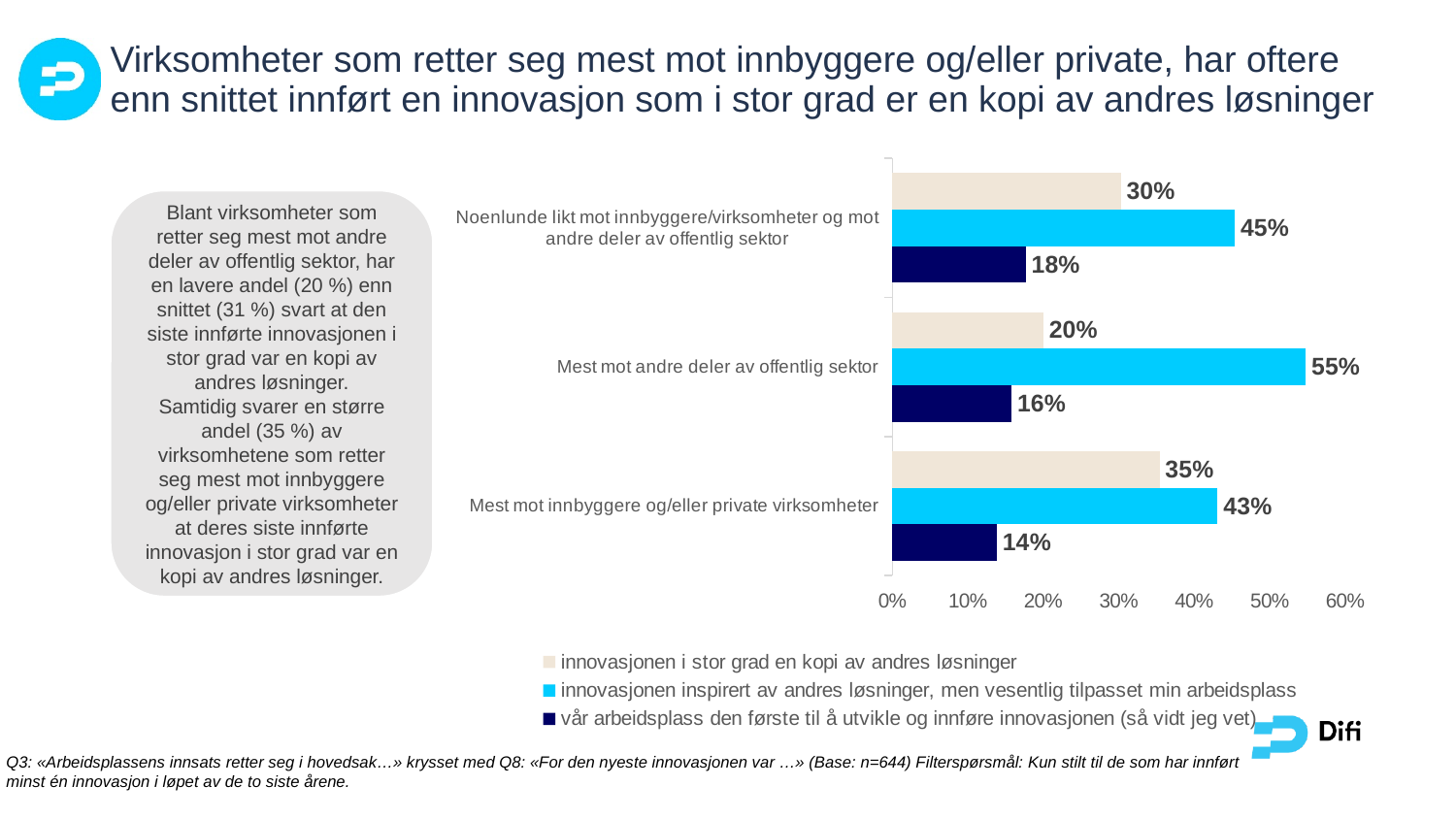
Which is larger: the 'innovasjonen i stor grad en kopi av andres løsninger' value for 'Noenlunde likt mot innbyggere/virksomheter og mot andre deler av offentlig sektor' or for 'Mest mot andre deler av offentlig sektor'? Noenlunde likt mot innbyggere/virksomheter og mot andre deler av offentlig sektor How many series does the legend list? 3 Is the value for 'innovasjonen inspirert av andres løsninger, men vesentlig tilpasset min arbeidsplass' in 'Mest mot andre deler av offentlig sektor' greater or less than 50%? greater How many categories are shown on the chart? 3 What is the value for 'innovasjonen inspirert av andres løsninger, men vesentlig tilpasset min arbeidsplass' in the category 'Mest mot andre deler av offentlig sektor'? 55% What is the value for 'vår arbeidsplass den første til å utvikle og innføre innovasjonen (så vidt jeg vet)' in the category 'Noenlunde likt mot innbyggere/virksomheter og mot andre deler av offentlig sektor'? 18% What is the value for 'innovasjonen i stor grad en kopi av andres løsninger' in the category 'Mest mot innbyggere og/eller private virksomheter'? 35% What is the maximum value shown on the x axis of the chart? 60% Which category has the highest value for 'innovasjonen i stor grad en kopi av andres løsninger'? Mest mot innbyggere og/eller private virksomheter What kind of chart is shown on the slide? bar chart Which category has the lowest value for 'vår arbeidsplass den første til å utvikle og innføre innovasjonen (så vidt jeg vet)'? Mest mot innbyggere og/eller private virksomheter What is the difference between the 'innovasjonen inspirert av andres løsninger, men vesentlig tilpasset min arbeidsplass' values for 'Mest mot andre deler av offentlig sektor' and 'Mest mot innbyggere og/eller private virksomheter'? 12%